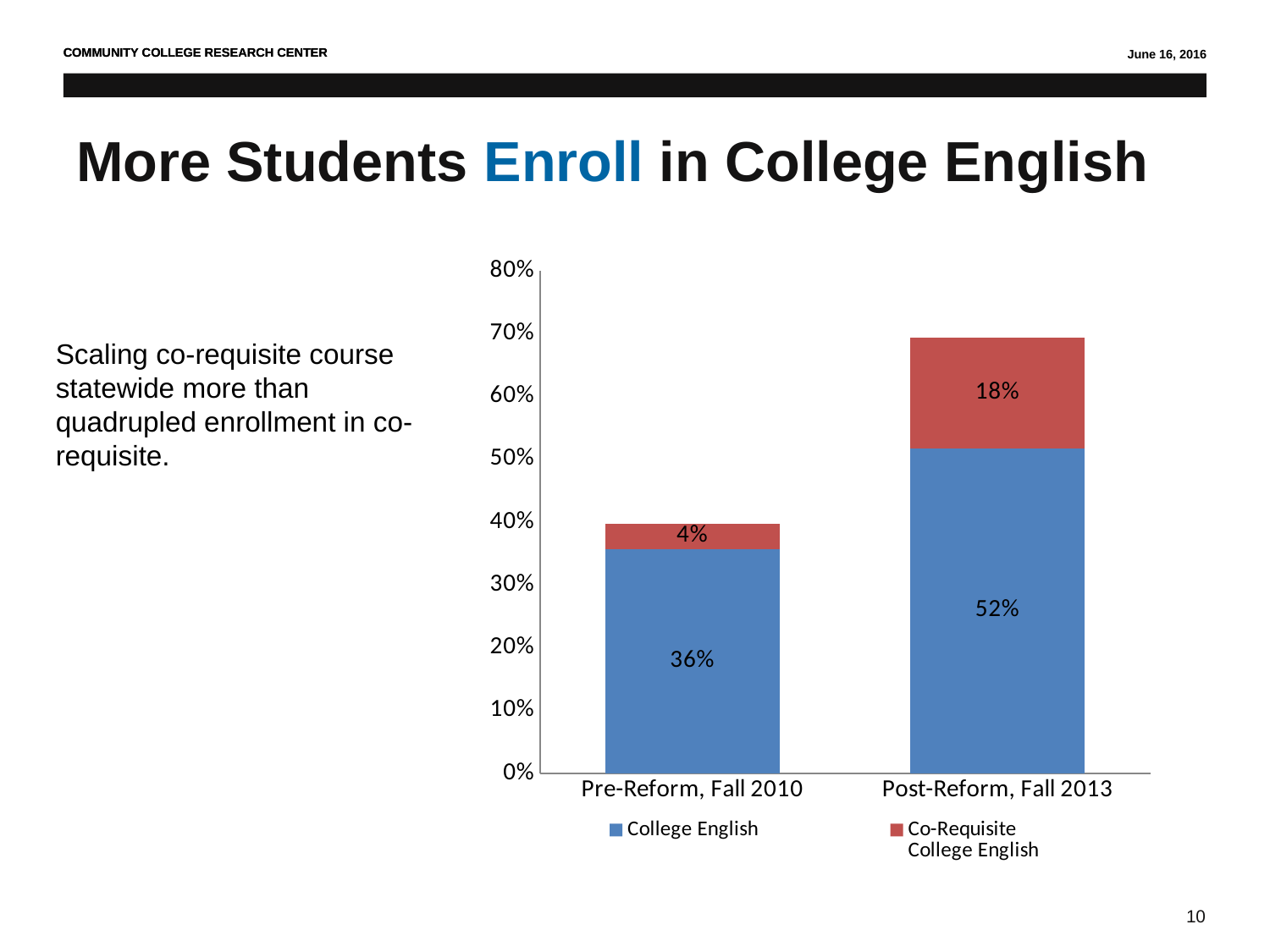
What is the difference between the College English values for Post-Reform, Fall 2013 and Pre-Reform, Fall 2010? 16% What is the total of the stacked bar for Post-Reform, Fall 2013? 70% How many categories are shown on the x axis? 2 Is the Co-Requisite College English value for Post-Reform, Fall 2013 larger or smaller than the Co-Requisite College English value for Pre-Reform, Fall 2010? larger What is the College English value for Post-Reform, Fall 2013? 52% How many series does the legend list? 2 What is the total of the stacked bar for Pre-Reform, Fall 2010? 40% What kind of chart is shown on the slide? stacked bar chart What is the Co-Requisite College English value for Pre-Reform, Fall 2010? 4% What is the Co-Requisite College English value for Post-Reform, Fall 2013? 18% What is the College English value for Pre-Reform, Fall 2010? 36% Which category has the higher College English value? Post-Reform, Fall 2013